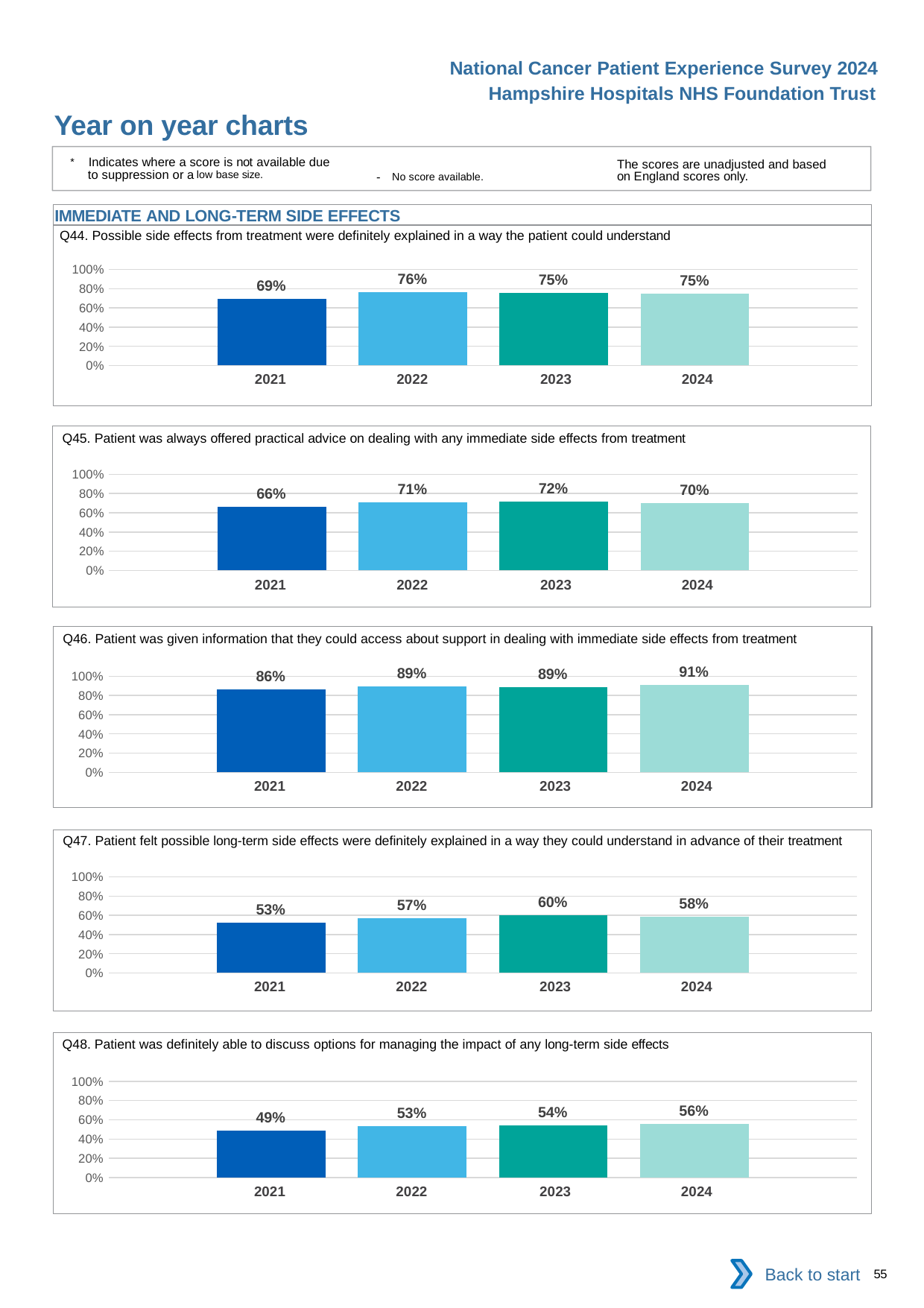
In the Q46 chart, what is the value for 2024? 91% In the Q48 chart, what is the difference between the 2024 value and the 2021 value? 7% In the Q48 chart, do the values rise or fall from 2021 to 2024? rise What kind of chart is the Q45 chart? bar chart In the Q45 chart, what is the difference between the 2023 value and the 2021 value? 6% In the Q46 chart, is the value for 2021 greater or less than 80%? greater In the Q47 chart, what is the value for 2021? 53% In the Q45 chart, which year has the highest value? 2023 In the Q44 chart, what is the value for 2022? 76% In the Q44 chart, which year has the lowest value? 2021 How many years are plotted in the Q44 chart? 4 In the Q47 chart, which is larger, the value for 2023 or the value for 2024? 2023